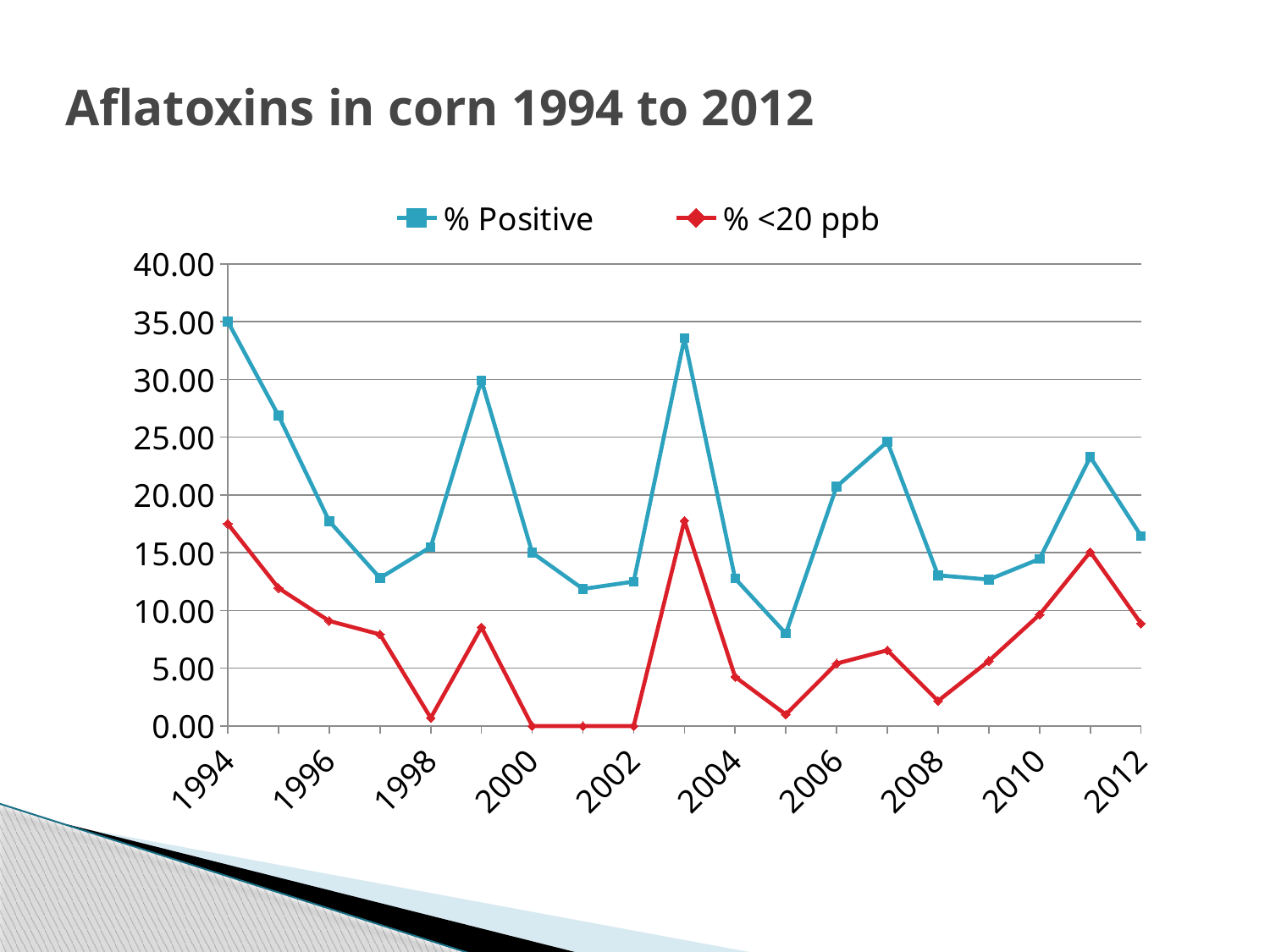
What kind of chart is shown on the slide? line chart Is the value for % <20 ppb in 2003 greater or less than 15.00? greater Does % Positive rise or fall from 1994 to 1997? fall How many series does the legend list? 2 Which series is drawn in red? % <20 ppb Is the value for % Positive in 2005 greater or less than 10.00? less In which year is % Positive lowest? 2005 Is the value for % Positive in 1994 greater or less than 30.00? greater What is the value of % <20 ppb in 2000? 0.00 Which is larger, % Positive in 1999 or % Positive in 2003? 2003 What is the title of the chart? Aflatoxins in corn 1994 to 2012